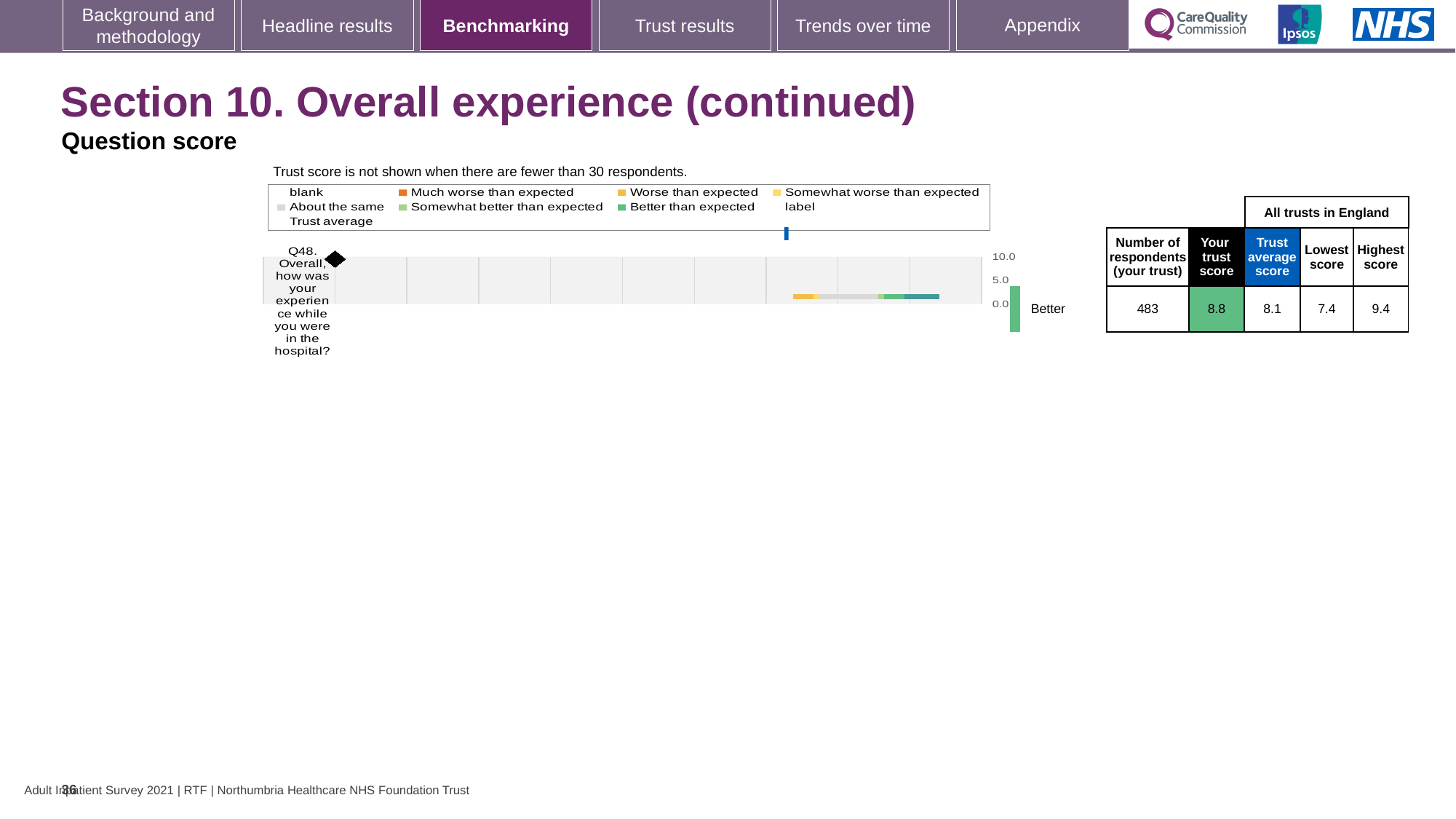
What word is printed next to the green bar to the right of the chart's axis? Better What is the lowest score among all trusts in England shown for Q48? 7.4 How many respondents from your trust are shown for Q48? 483 Is your trust score for Q48 greater or less than 5.0 on the chart's axis? greater Which is larger for Q48: your trust score or the trust average score? Your trust score What is the 'Your trust score' value shown for Q48 on the benchmarking chart? 8.8 How many survey questions are plotted on the benchmarking chart? 1 What is the highest score among all trusts in England shown for Q48? 9.4 What is the difference between the highest score and the lowest score shown for Q48? 2.0 What is the 'Trust average score' for all trusts in England shown for Q48? 8.1 By how much does your trust score for Q48 exceed the trust average score? 0.7 What kind of chart is used to show the Q48 benchmarking result? Bar chart